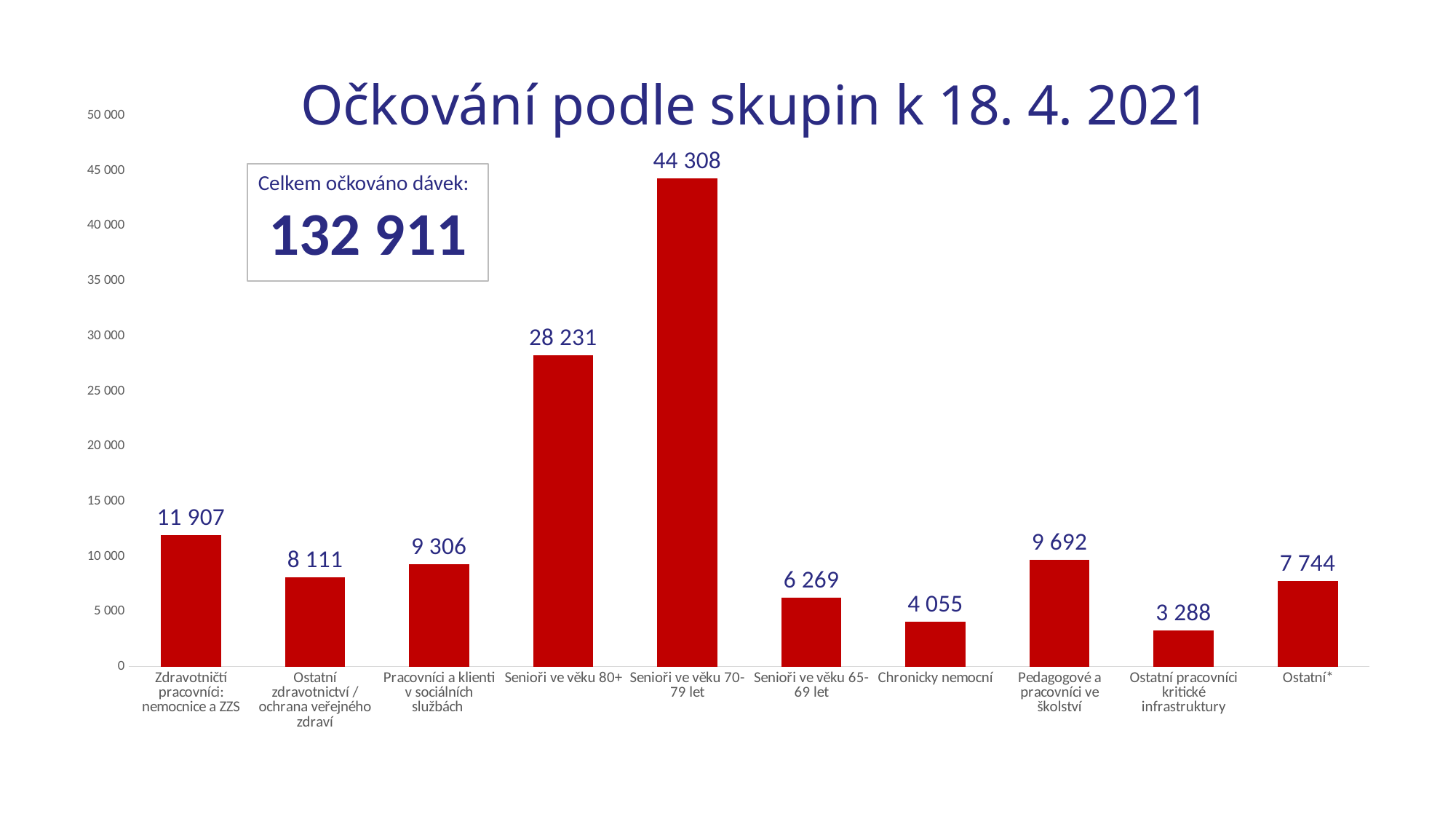
What total number of vaccine doses (Celkem očkováno dávek) is shown in the box on the slide? 132 911 Which category has the highest value? Senioři ve věku 70-79 let Which is larger: the value for Zdravotničtí pracovníci: nemocnice a ZZS or the value for Ostatní zdravotnictví / ochrana veřejného zdraví? Zdravotničtí pracovníci: nemocnice a ZZS Is the value for Senioři ve věku 80+ greater or less than 25 000? greater What is the value for Pedagogové a pracovníci ve školství? 9 692 What type of chart is shown on the slide? bar chart What is the value for Senioři ve věku 70-79 let? 44 308 What is the title of the chart? Očkování podle skupin k 18. 4. 2021 How many categories (bars) does the chart show? 10 What is the value for Chronicky nemocní? 4 055 What is the difference between the values for Senioři ve věku 70-79 let and Senioři ve věku 80+? 16 077 Which category has the lowest value? Ostatní pracovníci kritické infrastruktury